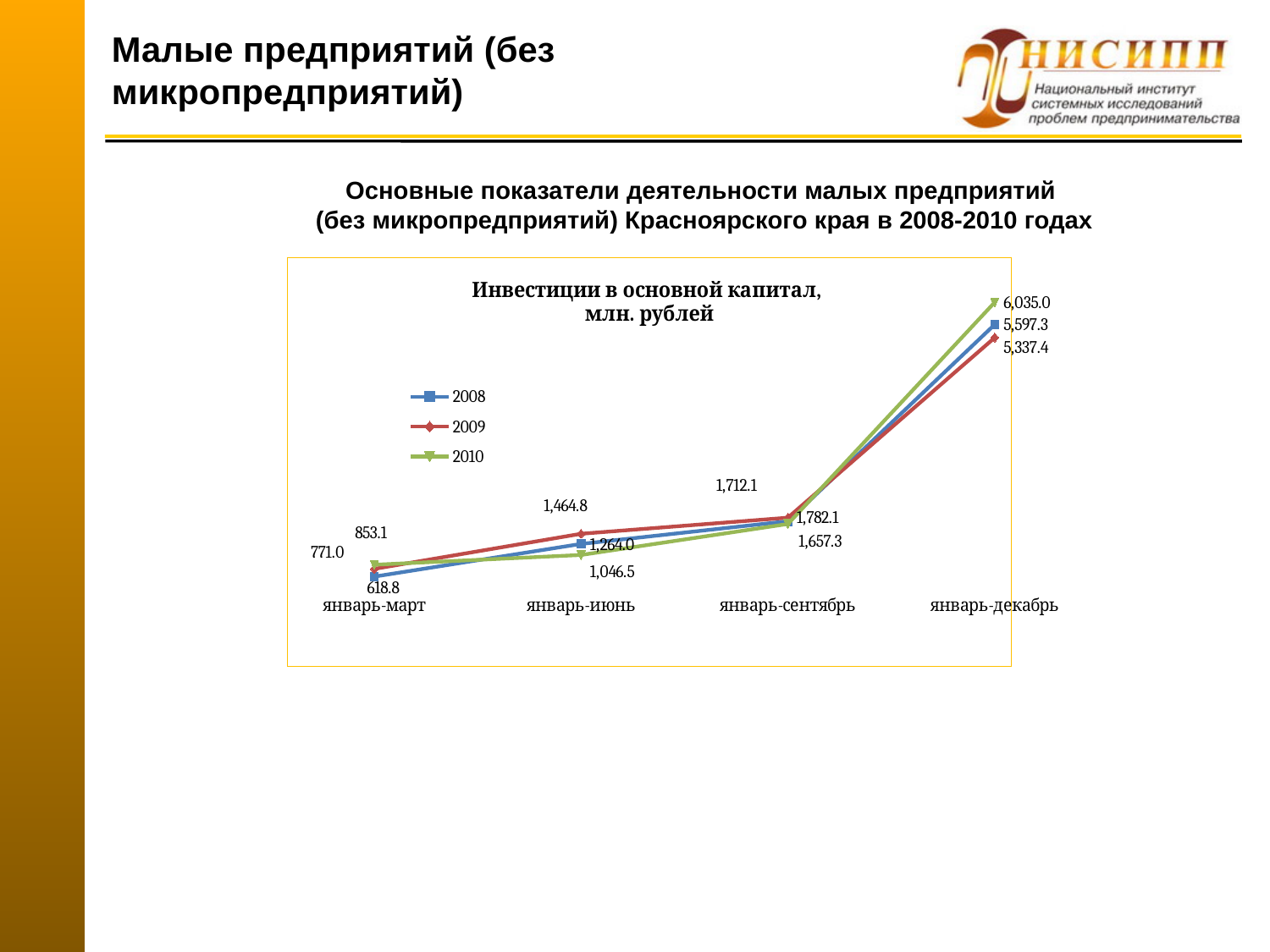
What is the value for 2009 in январь-декабрь? 5,337.4 Do the values for 2010 rise or fall from январь-март to январь-декабрь? rise Which series has the lowest value in январь-декабрь? 2009 What kind of chart is shown on the slide? line chart What is the value for 2008 in январь-декабрь? 5,597.3 What is the value for 2009 in январь-июнь? 1,464.8 What is the difference between the 2010 and 2009 values in январь-декабрь? 697.6 How many series does the chart legend list? 3 What is the title of the chart? Инвестиции в основной капитал, млн. рублей Which series has the highest value in январь-декабрь? 2010 How many categories are shown on the x axis of the chart? 4 What is the value for 2010 in январь-декабрь? 6,035.0